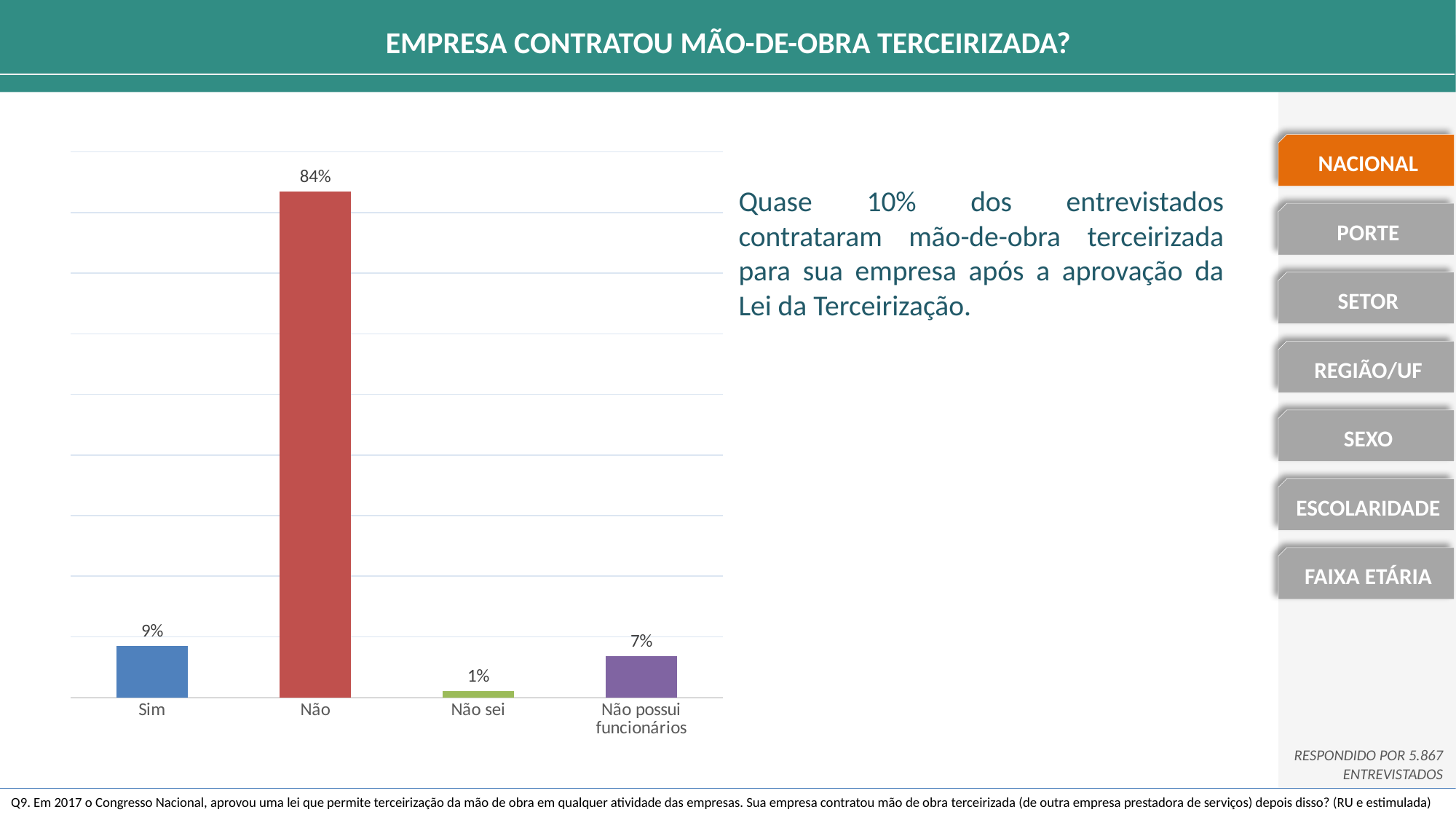
What kind of chart is shown on the slide? Bar chart Which category has the highest value? Não What is the value for "Não sei"? 1% Which category has the lowest value? Não sei What colour is the bar for "Não"? Red Which is larger, the value for "Sim" or the value for "Não possui funcionários"? Sim How many categories are shown on the chart? 4 What is the difference between the values for "Não" and "Sim"? 75% What is the value for "Não possui funcionários"? 7% What is the value for "Sim"? 9% What is the value for "Não"? 84% What is the difference between the values for "Sim" and "Não possui funcionários"? 2%